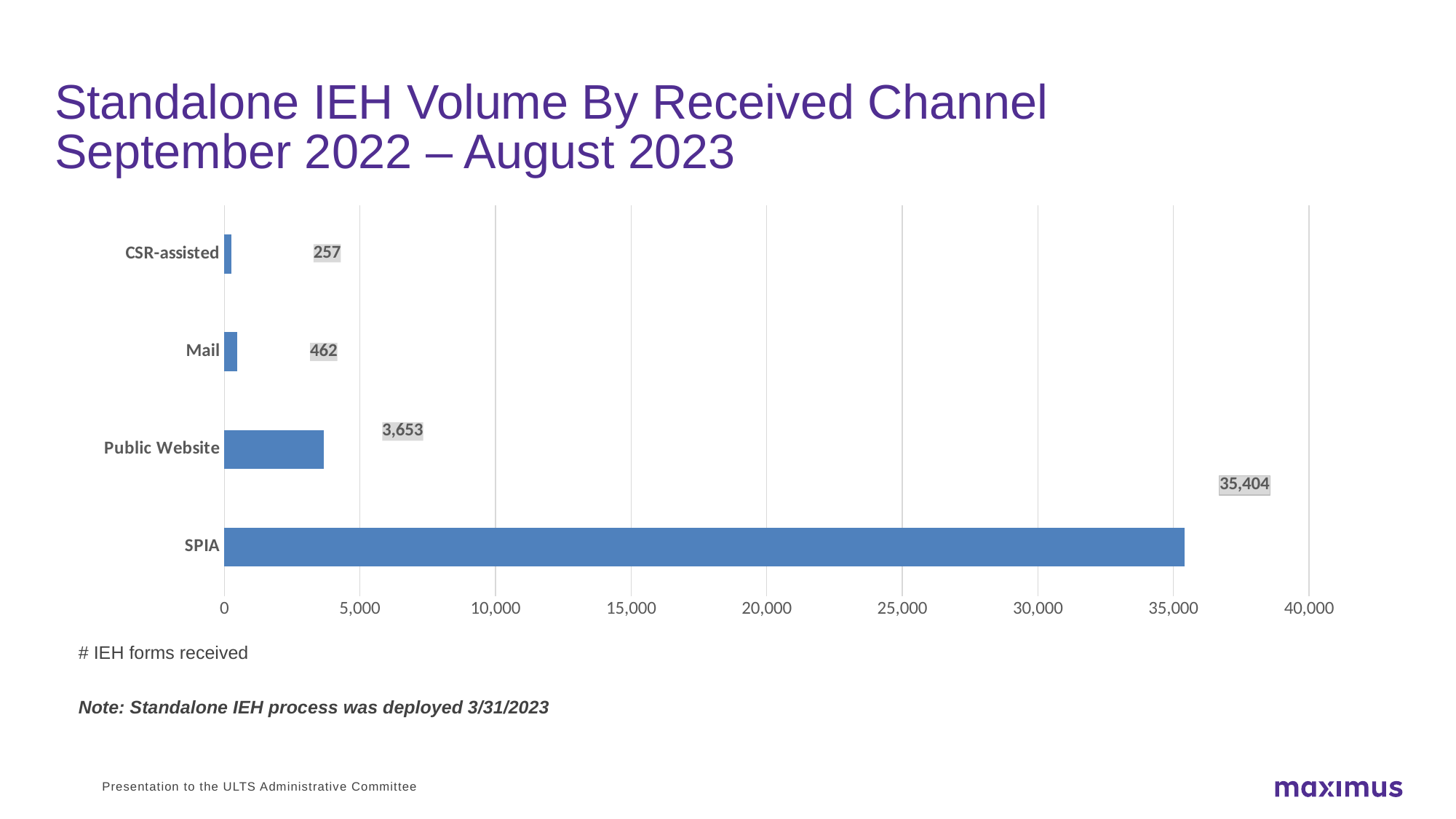
What is the value for Mail? 462 What is the value for SPIA? 35,404 Which is larger, the value for Mail or the value for Public Website? Public Website What is the difference between the Mail and CSR-assisted values? 205 What is the value for Public Website? 3,653 Which channel has the lowest volume? CSR-assisted What is the value for CSR-assisted? 257 How many channels are shown in the chart? 4 Which channel has the highest volume? SPIA What kind of chart is shown on the slide? Bar chart Is the value for SPIA greater or less than 30,000? greater What is the difference between the SPIA and Public Website values? 31,751